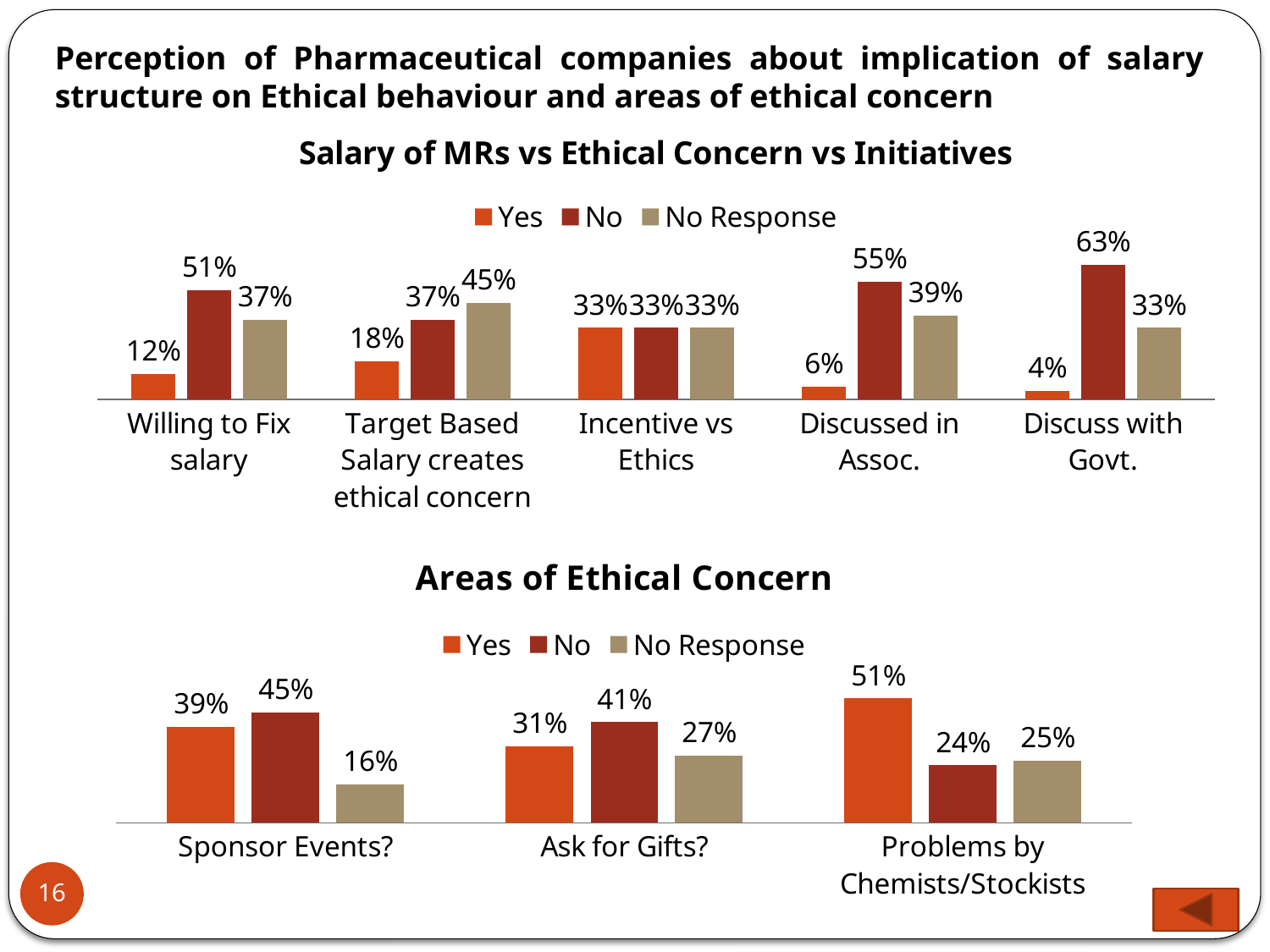
In the 'Salary of MRs vs Ethical Concern vs Initiatives' chart, which category has the lowest 'Yes' value? Discuss with Govt. In the 'Salary of MRs vs Ethical Concern vs Initiatives' chart, what is the difference between the 'No' and 'Yes' values for 'Discussed in Assoc.'? 49% In the 'Salary of MRs vs Ethical Concern vs Initiatives' chart, what is the 'Yes' value for 'Willing to Fix salary'? 12% In the 'Areas of Ethical Concern' chart, what is the 'No Response' value for 'Sponsor Events?'? 16% In the 'Areas of Ethical Concern' chart, which series is shown in the lightest (tan) colour? No Response What kind of chart is the 'Areas of Ethical Concern' chart? Bar chart In the 'Salary of MRs vs Ethical Concern vs Initiatives' chart, how many categories are shown on the x axis? 5 In the 'Areas of Ethical Concern' chart, what is the difference between the 'No' and 'No Response' values for 'Ask for Gifts?'? 14% In the 'Salary of MRs vs Ethical Concern vs Initiatives' chart, how many series does the legend list? 3 In the 'Areas of Ethical Concern' chart, is the 'Yes' value or the 'No' value larger for 'Ask for Gifts?'? No In the 'Areas of Ethical Concern' chart, which category has the highest 'Yes' value? Problems by Chemists/Stockists In the 'Salary of MRs vs Ethical Concern vs Initiatives' chart, what is the 'No' value for 'Discuss with Govt.'? 63%